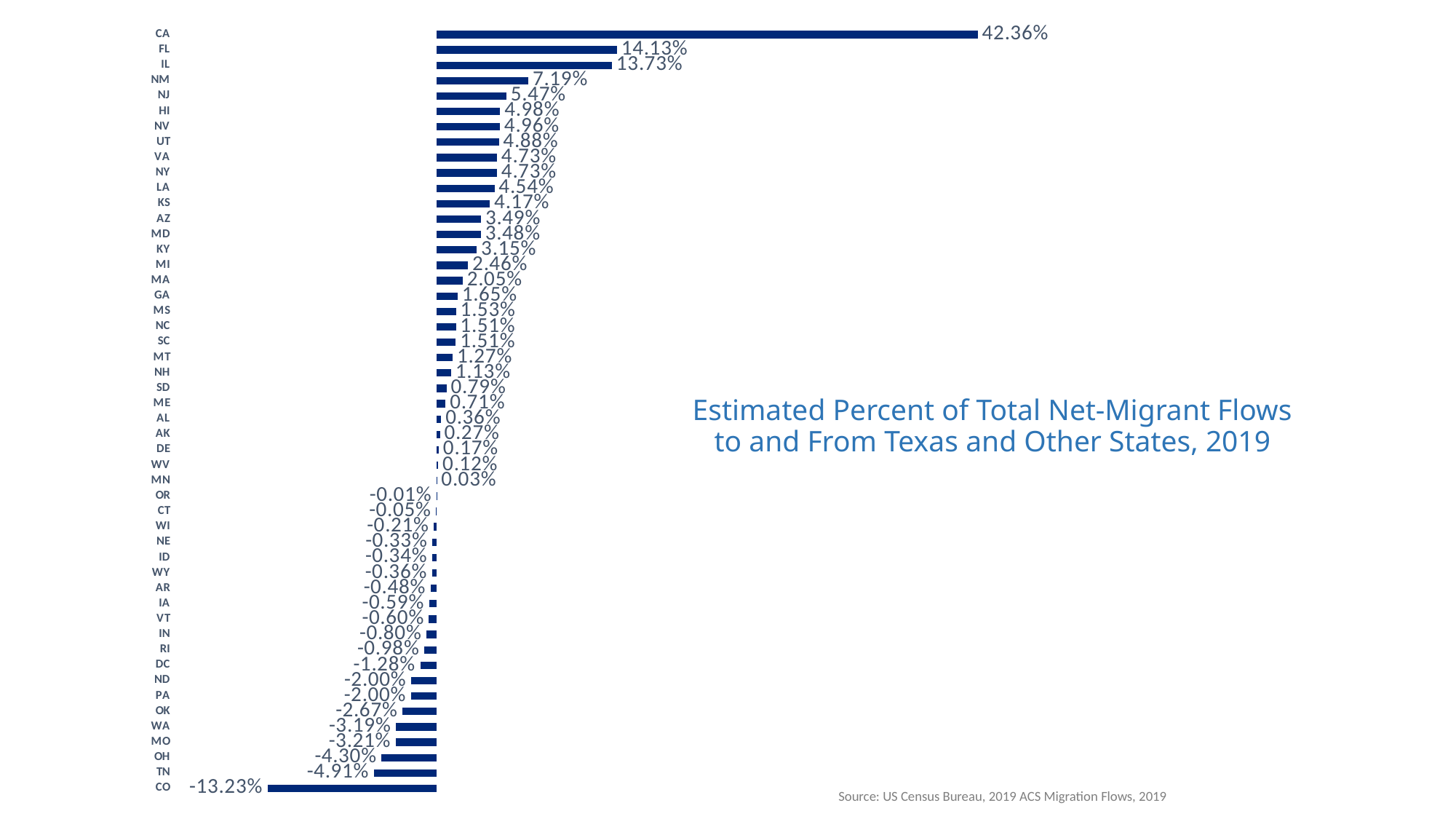
What is the difference between the values for CA and FL? 28.23 percentage points Which state has the highest value? CA What is the difference between the values for FL and IL? 0.40 percentage points What is the value for OK? -2.67% What kind of chart is this? Bar chart What is the value for CO? -13.23% What is the title of the chart? Estimated Percent of Total Net-Migrant Flows to and From Texas and Other States, 2019 What is the value for NM? 7.19% Which has a larger value, NJ or HI? NJ Which state has the lowest value? CO How many states are plotted on the chart? 50 What is the value for CA? 42.36%